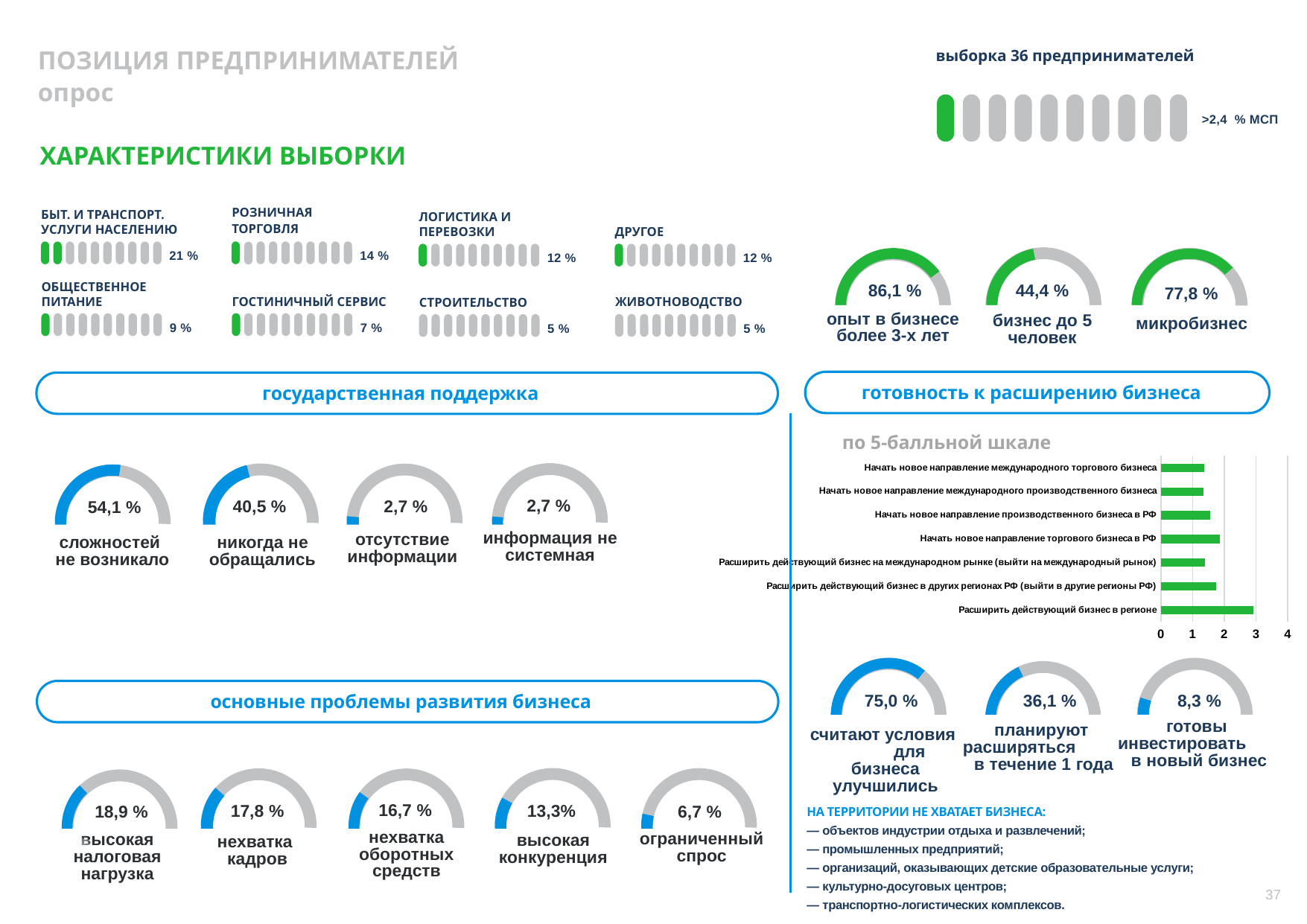
In the 'по 5-балльной шкале' bar chart, which is larger: 'Расширить действующий бизнес в регионе' or 'Начать новое направление торгового бизнеса в РФ'? Расширить действующий бизнес в регионе What kind of chart is the 'по 5-балльной шкале' chart under 'готовность к расширению бизнеса'? bar chart In the 'государственная поддержка' gauges, what share of respondents answered 'сложностей не возникало'? 54,1 % In the 'по 5-балльной шкале' bar chart, which category has the highest value? Расширить действующий бизнес в регионе In the 'основные проблемы развития бизнеса' gauges, which problem has the highest share? высокая налоговая нагрузка In the 'готовность к расширению бизнеса' gauges, what share of respondents 'планируют расширяться в течение 1 года'? 36,1 % In the 'ХАРАКТЕРИСТИКИ ВЫБОРКИ' section, what share of the sample is 'РОЗНИЧНАЯ ТОРГОВЛЯ'? 14 % In the 'основные проблемы развития бизнеса' gauges, what is the value for 'ограниченный спрос'? 6,7 % In the 'государственная поддержка' gauges, what is the difference between 'сложностей не возникало' and 'никогда не обращались'? 13,6 % In the 'по 5-балльной шкале' bar chart, is the value for 'Начать новое направление международного торгового бизнеса' greater or less than 2? less How many categories does the 'по 5-балльной шкале' bar chart show? 7 In the 'по 5-балльной шкале' bar chart, is the value for 'Расширить действующий бизнес в регионе' greater or less than 2? greater